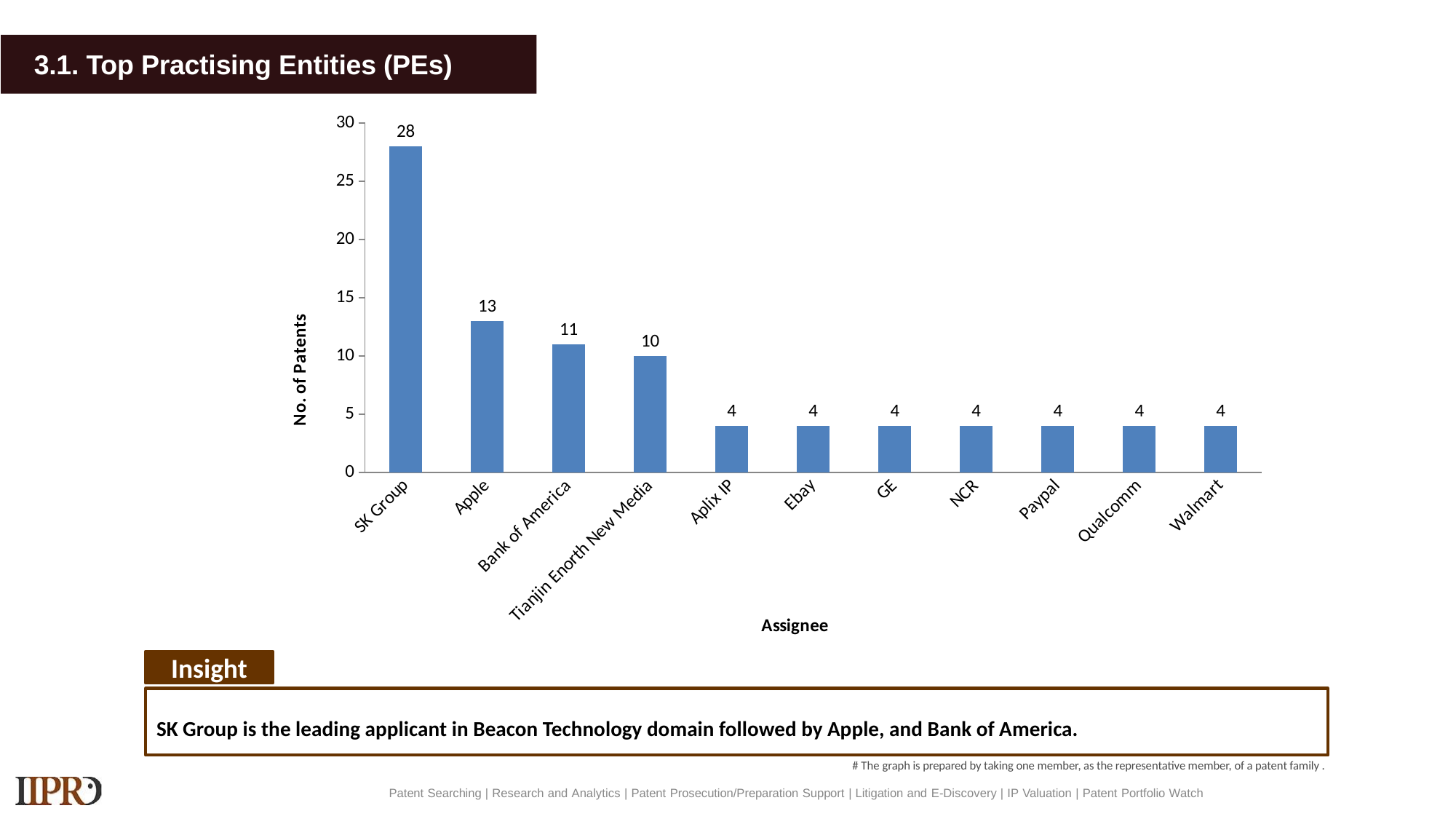
How many assignees have exactly 4 patents? 7 What is the label of the y-axis? No. of Patents What is the difference in number of patents between Apple and Bank of America? 2 What is the difference in number of patents between SK Group and Apple? 15 Is the value for SK Group greater or less than 25? greater How many patents does SK Group have? 28 Which assignee has the highest number of patents? SK Group What kind of chart is shown on the slide? Bar chart What is the number of patents for Bank of America? 11 How many patents does Tianjin Enorth New Media have? 10 Which has more patents, Bank of America or Qualcomm? Bank of America How many assignees are shown on the chart? 11